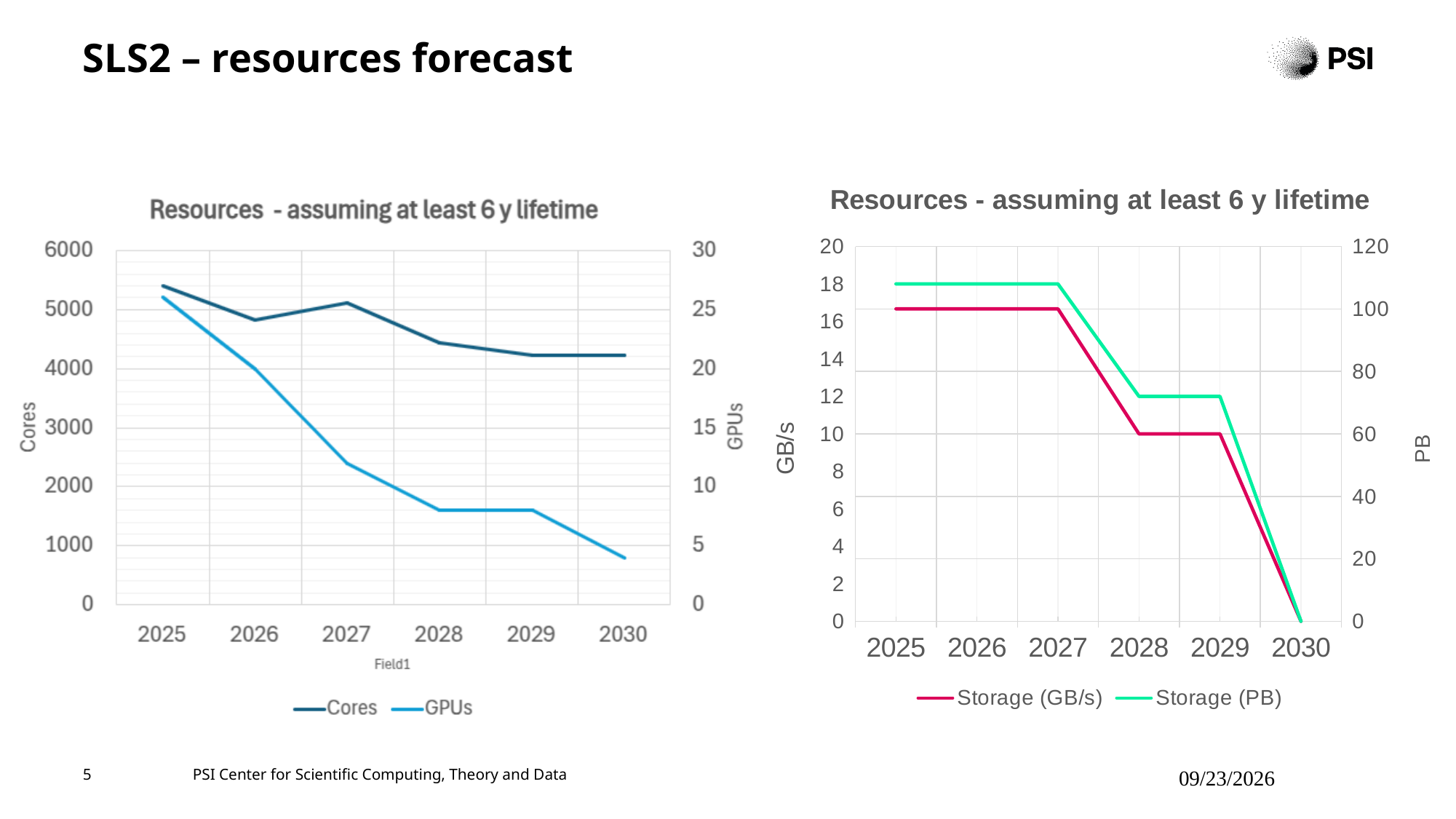
How many years are plotted on the x axis of the right chart? 6 What type of chart is the left chart on the slide? line chart In the right chart, what is the value of Storage (PB) in 2030? 0 In the left chart, is the value for GPUs in 2030 greater or less than 5? less In the left chart, which is larger: Cores in 2026 or Cores in 2027? Cores in 2027 In the left chart, which year has the lowest value for GPUs? 2030 In the left chart, which year has the highest value for Cores? 2025 In the right chart, do the Storage (GB/s) values rise or fall from 2025 to 2030? fall In the right chart, is the value for Storage (PB) in 2025 greater or less than 100? less In the left chart, is the value for Cores in 2025 greater or less than 5000? greater How many series does the legend of the left chart list? 2 In the right chart, what is the value of Storage (GB/s) in 2028? 60